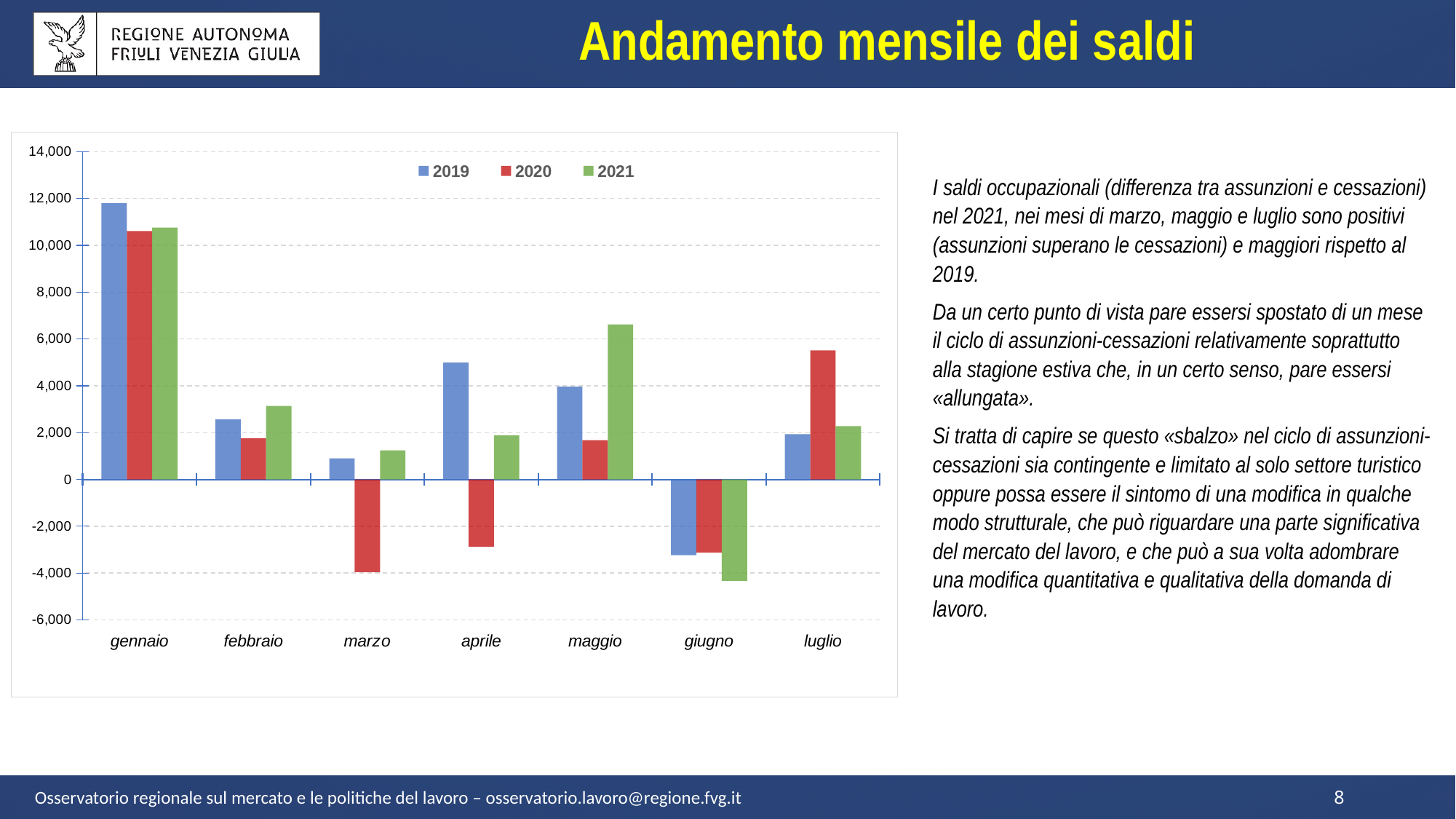
Is the value for 2019 in gennaio greater or less than 10,000? greater How many series does the legend list? 3 What kind of chart is shown on the slide? bar chart In aprile, which series has the larger value, 2019 or 2021? 2019 Which month has the lowest value for the 2021 series? giugno Is the value for 2020 in marzo greater or less than -2,000? less Which month has the lowest value for the 2020 series? marzo Is the value for 2021 in giugno greater or less than -4,000? less Which month has the highest value for the 2021 series? gennaio How many months are shown on the x axis? 7 In luglio, which series has the larger value, 2019 or 2020? 2020